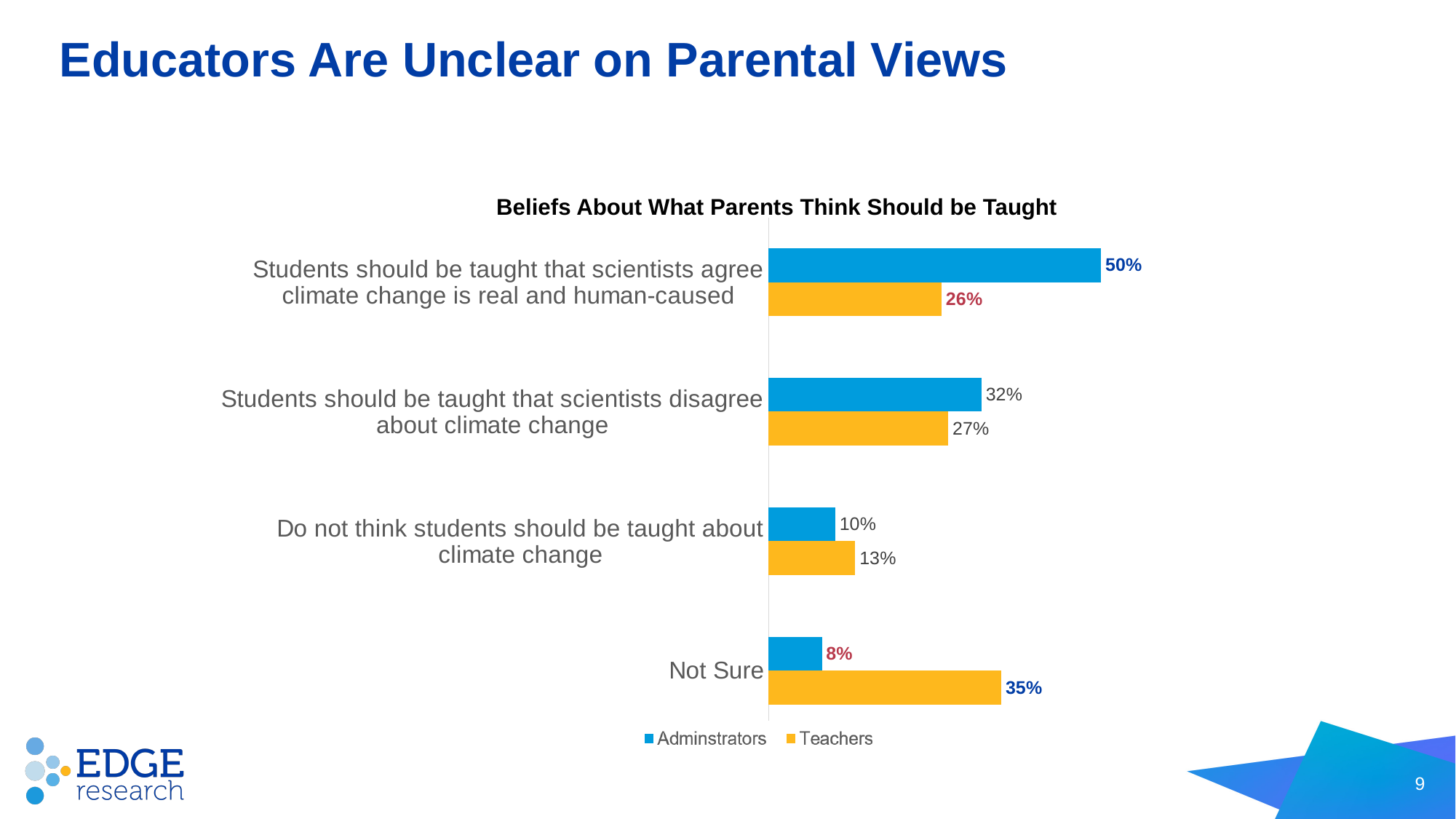
What is the Administrators value for 'Students should be taught that scientists disagree about climate change'? 32% What percentage of Teachers believe parents think students should be taught that scientists agree climate change is real and human-caused? 26% Which category has the highest Teachers value? Not Sure Which category has the lowest Administrators value? Not Sure For 'Do not think students should be taught about climate change', which group has the larger value, Administrators or Teachers? Teachers What is the Teachers value for 'Not Sure'? 35% How many series does the legend list? 2 How many categories are shown in the chart? 4 What is the difference between the Administrators and Teachers values for 'Not Sure'? 27% What percentage of Administrators believe parents think students should be taught that scientists agree climate change is real and human-caused? 50% What type of chart is shown on the slide? Bar chart Which category has the highest Administrators value? Students should be taught that scientists agree climate change is real and human-caused